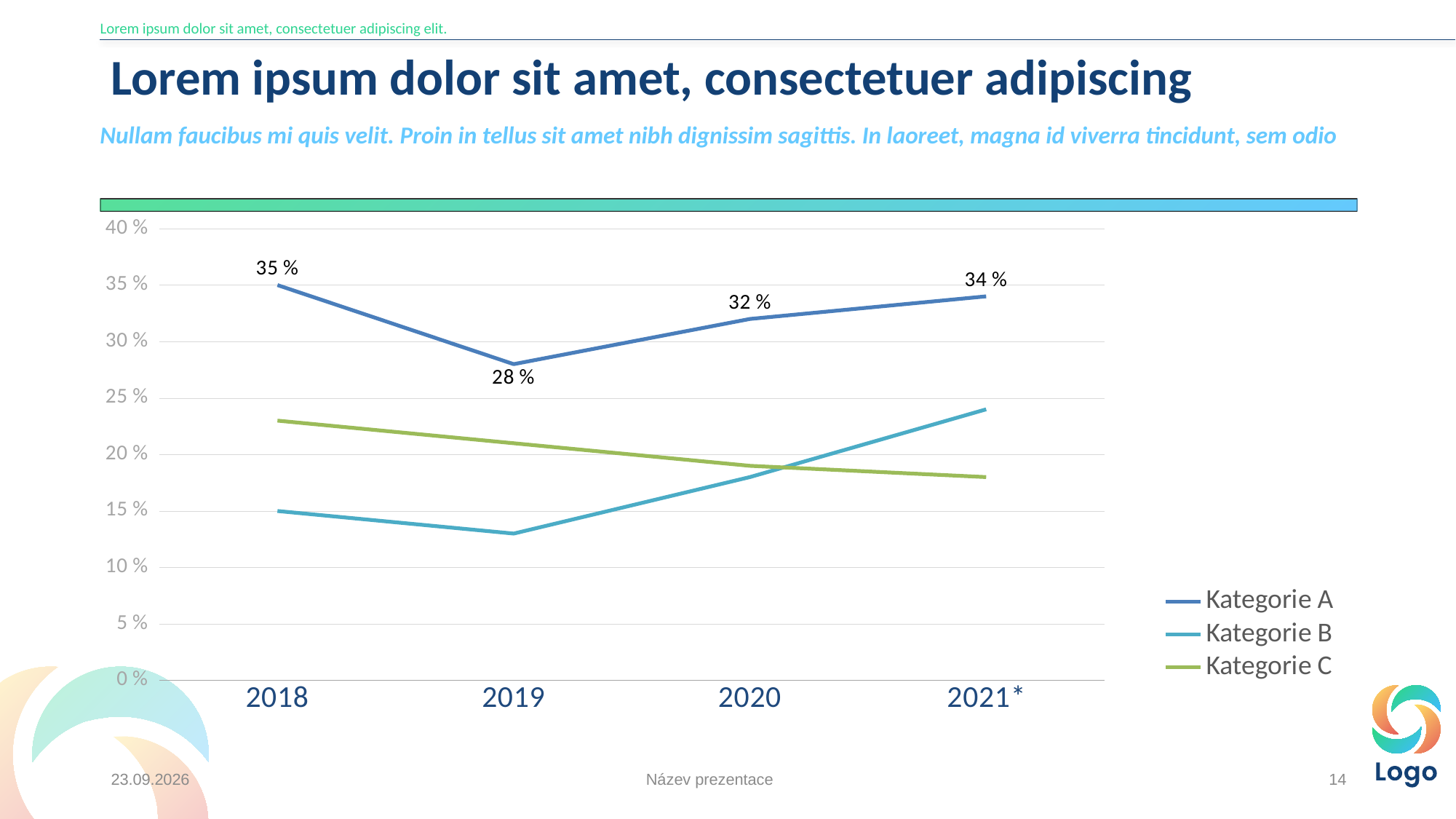
What kind of chart is shown on the slide? Line chart In which year is Kategorie A at its lowest? 2019 What is the value for Kategorie A in 2019? 28 % How many series does the legend list? 3 Which is larger for Kategorie A: the value for 2020 or the value for 2021*? 2021* Is the value for Kategorie B in 2019 greater or less than 15 %? less In which year is Kategorie A at its highest? 2018 What is the value for Kategorie A in 2021*? 34 % Is the value for Kategorie C in 2018 greater or less than 20 %? greater Does Kategorie C rise or fall from 2018 to 2021*? Fall What is the value for Kategorie A in 2018? 35 % What is the difference between the Kategorie A values for 2018 and 2019? 7 %